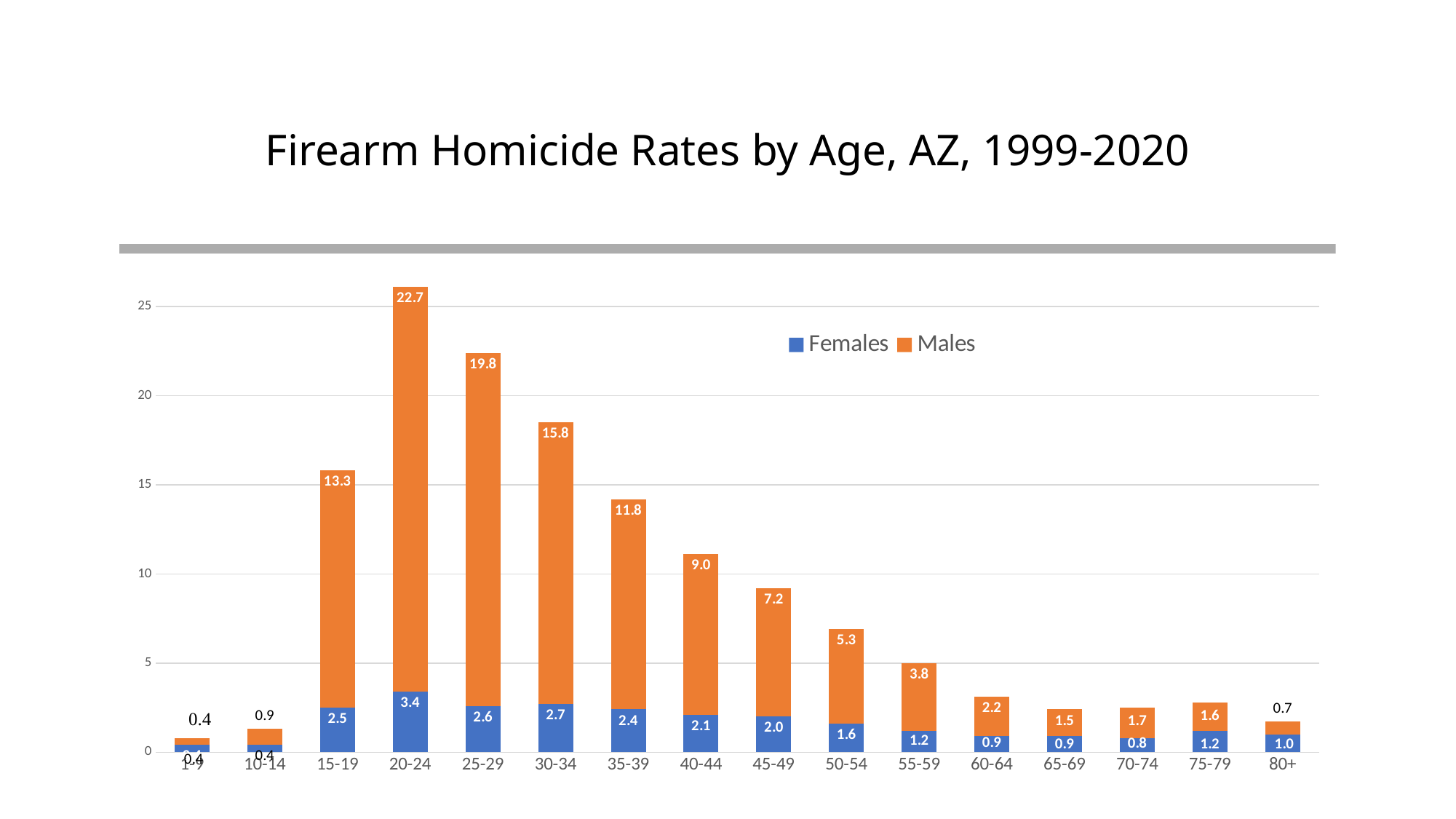
Which age group has the highest Males value? 20-24 Which age group has the lowest Males value? 1-9 What is the Females value for the 30-34 age group? 2.7 What type of chart is shown on the slide? Stacked bar chart What is the Males value for the 20-24 age group? 22.7 Which is larger, the Males value for 40-44 or for 45-49? 40-44 What is the difference between the Males values for the 20-24 and 25-29 age groups? 2.9 Which age group has the highest Females value? 20-24 How many series does the legend list? 2 How many age groups are shown on the x axis? 16 What is the Males value for the 50-54 age group? 5.3 What is the total of the stacked bar for the 15-19 age group? 15.8